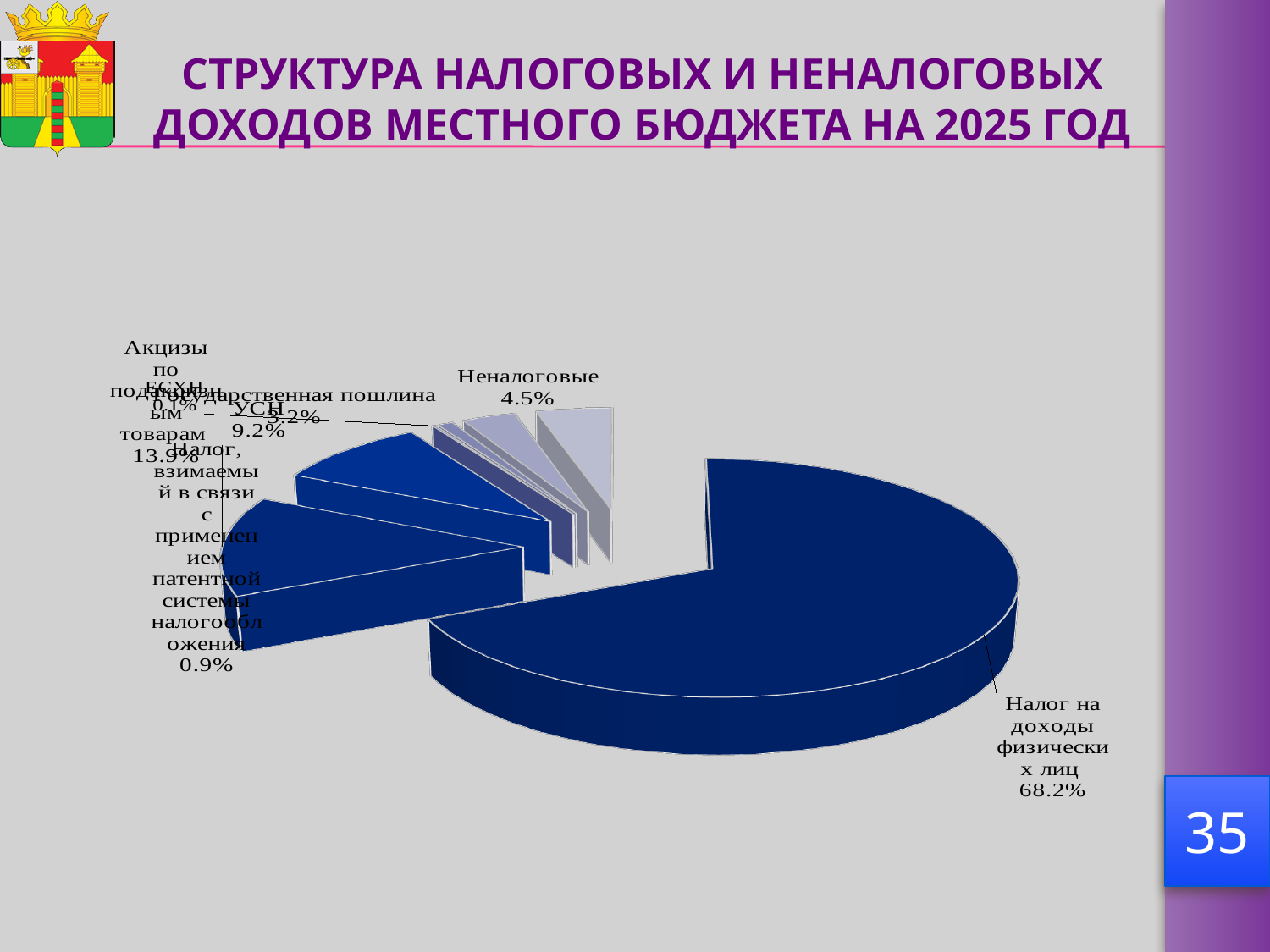
What kind of chart is shown on the slide? Pie chart What share is shown for "УСН"? 9.2% What share is shown for "Неналоговые"? 4.5% Which is larger: the share for "Неналоговые" or the share for the patent system tax ("Налог, взимаемый в связи с применением патентной системы налогообложения")? Неналоговые What share is shown for "Налог, взимаемый в связи с применением патентной системы налогообложения"? 0.9% By how many percentage points does "УСН" exceed "Неналоговые"? 4.7% What share of the pie is labelled for "Налог на доходы физических лиц"? 68.2% Which is larger: the share for "Акцизы по подакцизным товарам" or the share for "УСН"? Акцизы по подакцизным товарам Which category has the largest slice of the pie? Налог на доходы физических лиц What is the title of the slide containing the chart? СТРУКТУРА НАЛОГОВЫХ И НЕНАЛОГОВЫХ ДОХОДОВ МЕСТНОГО БЮДЖЕТА НА 2025 ГОД What share is shown for "Акцизы по подакцизным товарам"? 13.9% By how many percentage points does "Налог на доходы физических лиц" exceed "Акцизы по подакцизным товарам"? 54.3%